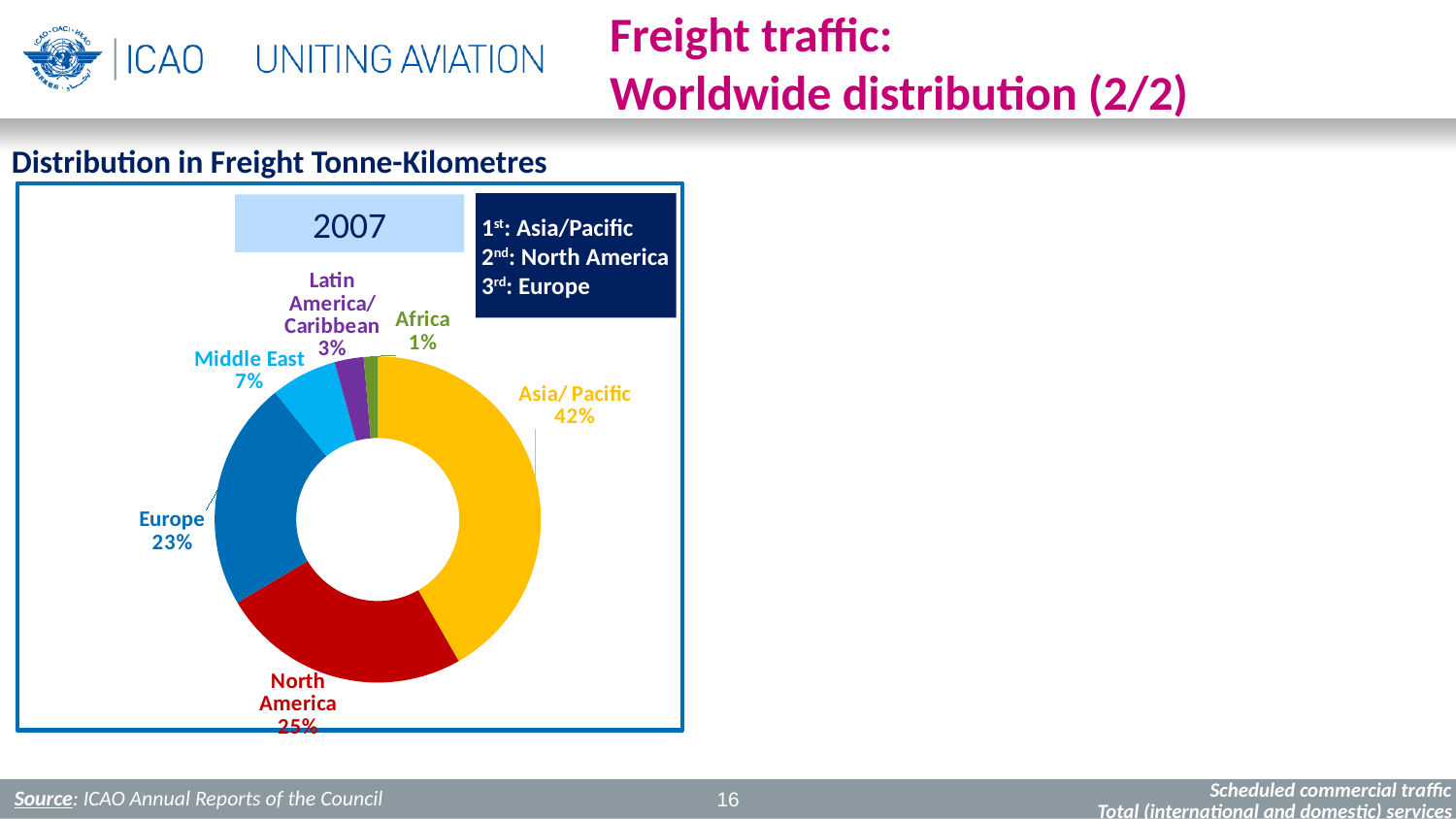
What share of freight tonne-kilometres does Asia/Pacific account for in 2007? 42% What percentage is shown for Latin America/Caribbean? 3% Which region has the smallest share of freight tonne-kilometres? Africa What is the difference in percentage points between Asia/Pacific and North America? 17 percentage points What percentage is shown for the Middle East? 7% Which has a larger share, Europe or the Middle East? Europe Which region has the largest share of freight tonne-kilometres? Asia/Pacific What percentage is shown for Europe? 23% What percentage is shown for North America? 25% How many regions are shown in the chart? 6 Which year does the chart refer to? 2007 What kind of chart is shown on the slide? Pie chart (doughnut)